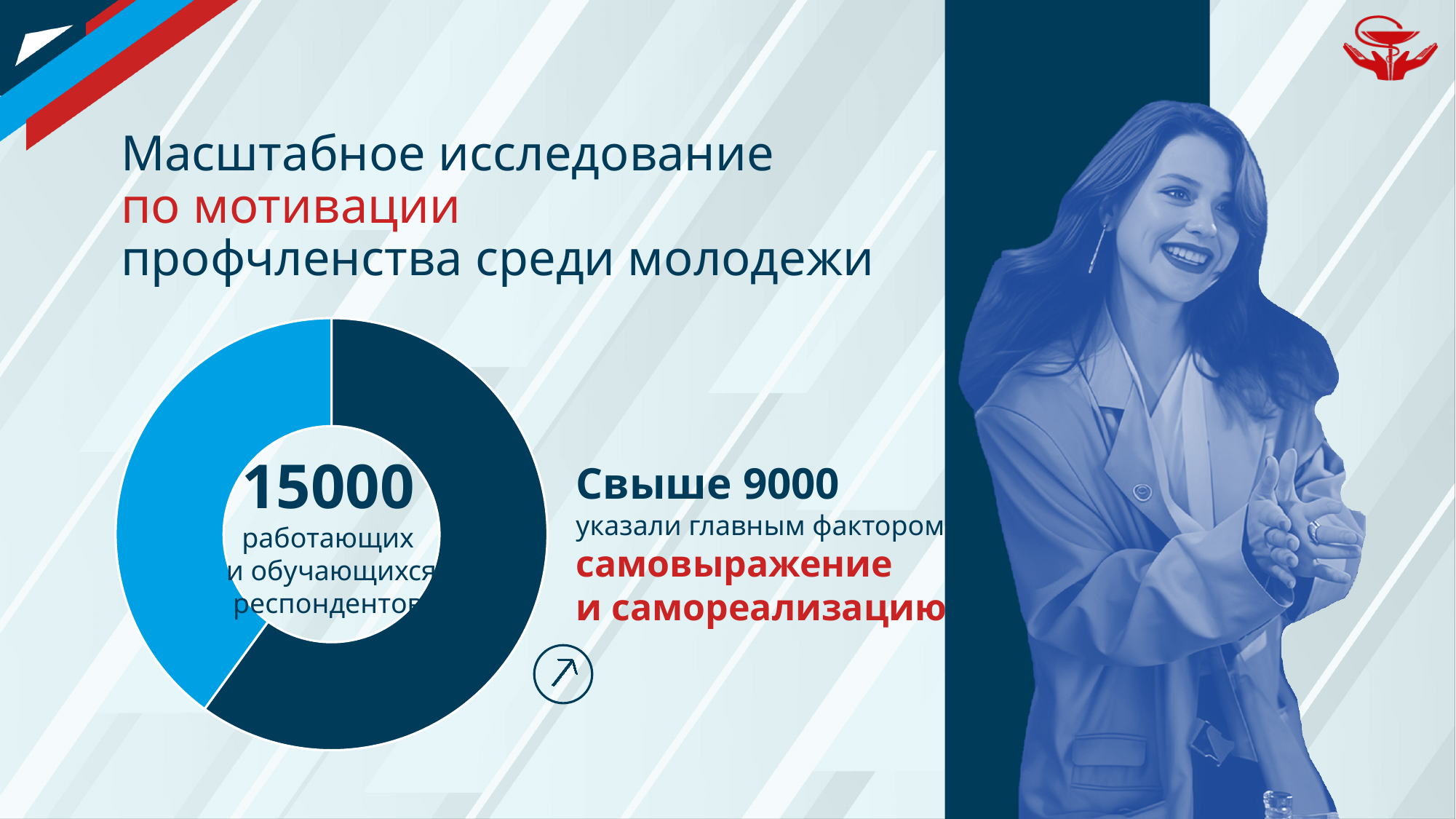
What number is printed in the centre of the donut chart? 15000 What number is given next to the chart for respondents who named self-expression and self-realisation as the main factor? Свыше 9000 Is the dark blue segment of the donut chart greater or less than half of the whole? greater Is the light blue segment of the donut chart greater or less than half of the whole? less Which segment of the donut chart is larger, the dark blue one or the light blue one? The dark blue one What kind of chart is shown on the slide? Donut (pie) chart According to the text in the centre of the donut chart, what does the number 15000 represent? работающих и обучающихся респондентов How many segments does the donut chart have? 2 Which segment of the donut chart is the smallest? The light blue segment